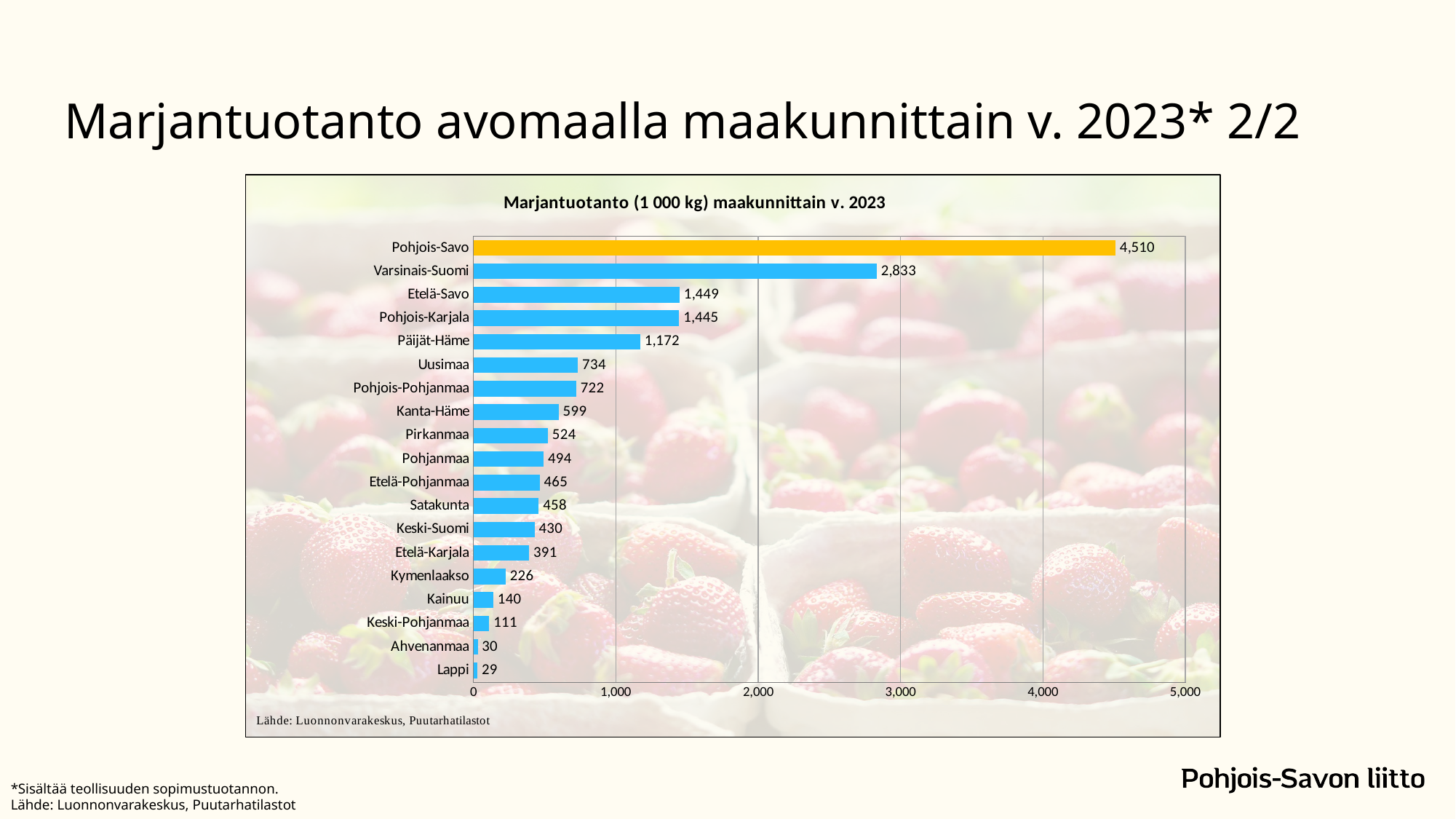
How many regions are shown in the chart? 19 What is the value for Pohjois-Savo? 4,510 What is the value for Päijät-Häme? 1,172 What is the value for Kymenlaakso? 226 Which region has the highest value? Pohjois-Savo What is the difference between the values for Uusimaa and Pohjois-Pohjanmaa? 12 What kind of chart is shown on the slide? bar chart Which region has the lowest value? Lappi Which region's bar is coloured differently (orange) from the others? Pohjois-Savo What is the difference between the values for Pohjois-Savo and Varsinais-Suomi? 1,677 Which is larger, the value for Kanta-Häme or the value for Pirkanmaa? Kanta-Häme Is the value for Varsinais-Suomi greater or less than 3,000? less